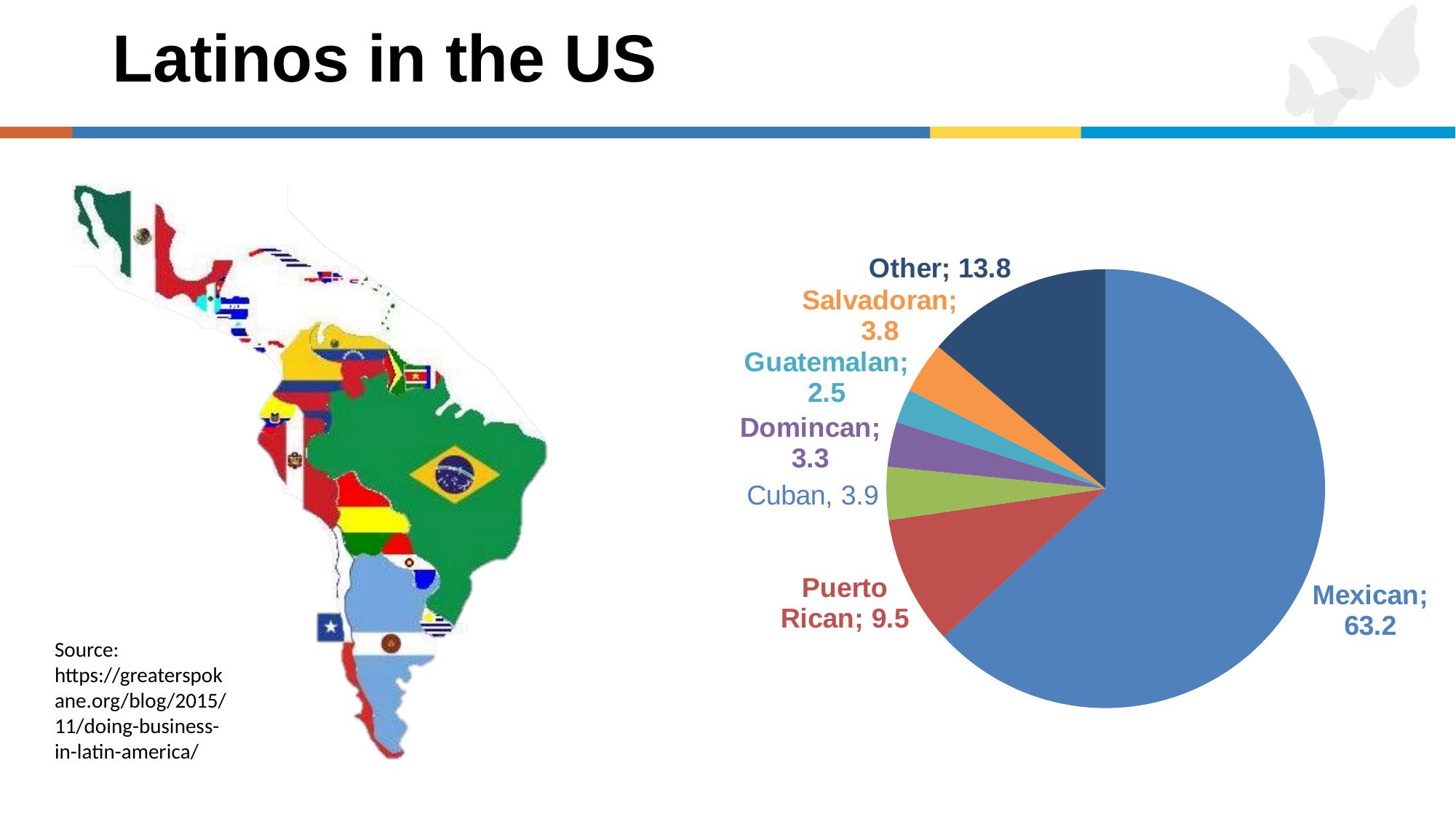
What is the value for Other in the pie chart? 13.8 What kind of chart is shown on the slide? pie chart What is the value for Puerto Rican in the pie chart? 9.5 How many slices does the pie chart have? 7 Which is larger, the value for Salvadoran or the value for Domincan? Salvadoran What is the difference between the values for Mexican and Puerto Rican? 53.7 Which category has the largest slice of the pie chart? Mexican What is the value for Guatemalan in the pie chart? 2.5 What is the value for Cuban in the pie chart? 3.9 What is the value for Mexican in the pie chart? 63.2 Which category has the smallest slice of the pie chart? Guatemalan What is the difference between the values for Other and Cuban? 9.9